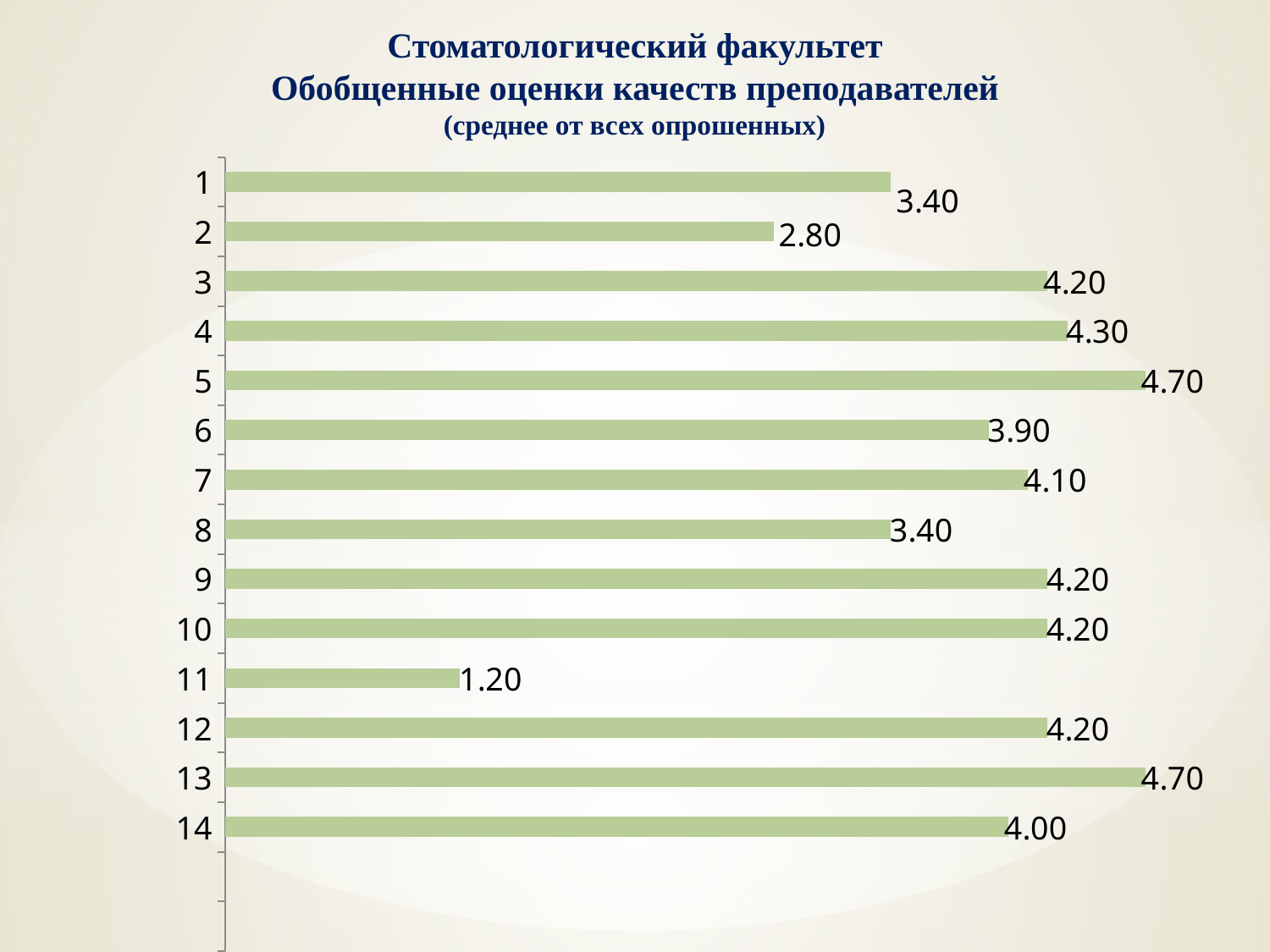
What kind of chart is shown on the slide? bar chart How many categories are shown in the chart? 14 What is the difference between the values for category 5 and category 11? 3.50 What is the value for category 2? 2.80 Which is larger, the value for category 6 or the value for category 7? category 7 What is the difference between the values for category 4 and category 2? 1.50 What is the value for category 11? 1.20 Which category has the lowest value? 11 Which categories share the highest value of 4.70? 5 and 13 What is the first line of the chart title? Стоматологический факультет What is the value for category 14? 4.00 What is the value for category 5? 4.70